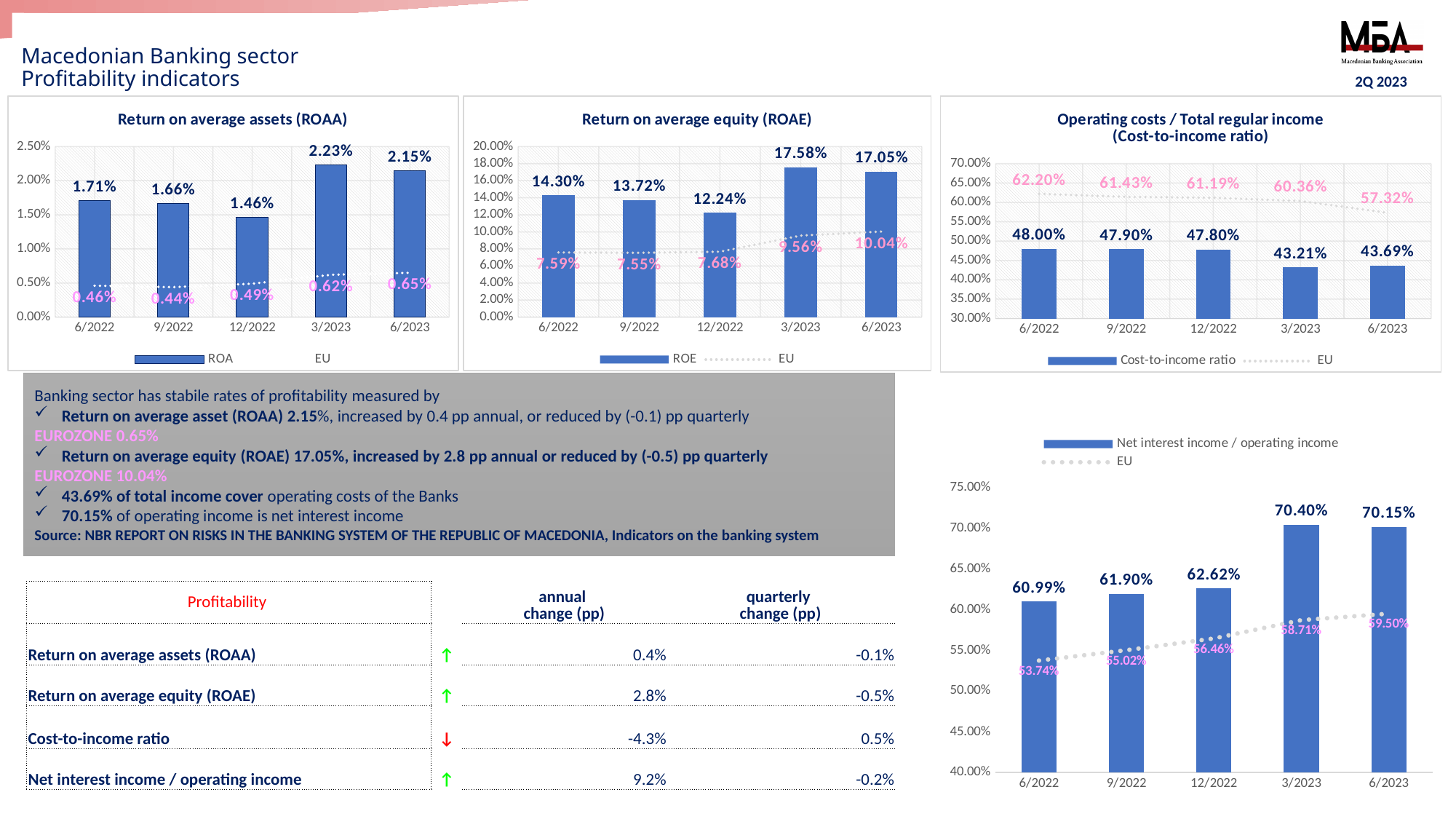
How many periods are shown on the x axis of the Return on average assets (ROAA) chart? 5 In the Operating costs / Total regular income (Cost-to-income ratio) chart, does the EU value rise or fall from 6/2022 to 6/2023? fall In the Return on average assets (ROAA) chart, what is the ROA value for 3/2023? 2.23% In the Operating costs / Total regular income (Cost-to-income ratio) chart, which is larger for 6/2023: the Cost-to-income ratio or the EU value? EU In the Return on average assets (ROAA) chart, which period has the lowest ROA value? 12/2022 In the Return on average equity (ROAE) chart, which period has the highest ROE value? 3/2023 How many series does the legend of the Operating costs / Total regular income (Cost-to-income ratio) chart list? 2 In the Return on average equity (ROAE) chart, what is the EU value for 6/2023? 10.04% In the Return on average equity (ROAE) chart, what is the difference between the ROE value for 3/2023 and the ROE value for 6/2023? 0.53% In the Net interest income / operating income chart at the bottom right, what is the difference between the Net interest income / operating income value and the EU value for 6/2023? 10.65% In the Net interest income / operating income chart at the bottom right, what is the Net interest income / operating income value for 12/2022? 62.62% In the Operating costs / Total regular income (Cost-to-income ratio) chart, what is the Cost-to-income ratio for 9/2022? 47.90%